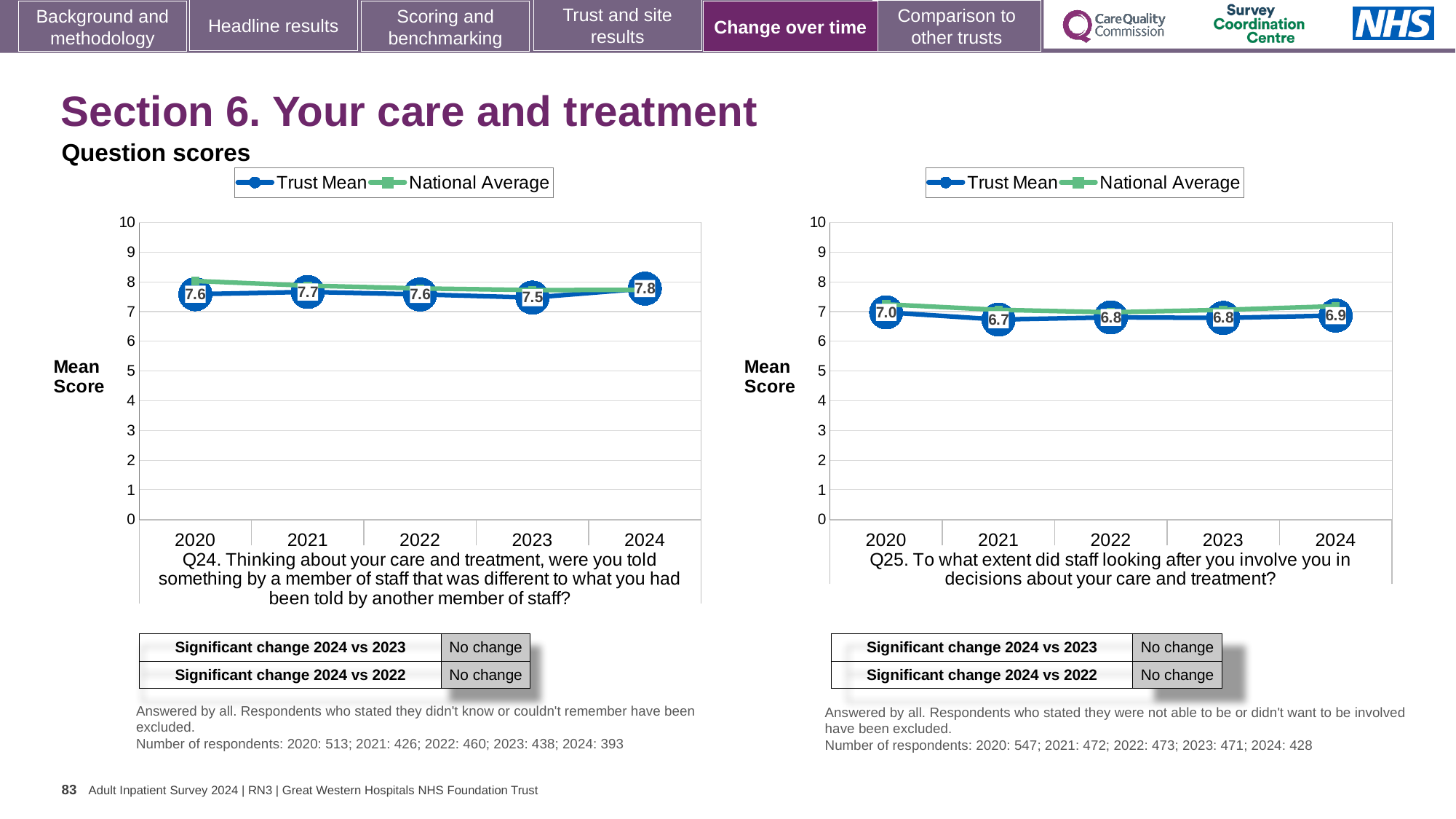
In the Q25 chart on the right, is the National Average value for 2022 greater or less than 8? less In the Q24 chart on the left, is the National Average value for 2020 greater or less than 7? greater In the Q24 chart on the left, what is the difference between the Trust Mean scores for 2024 and 2023? 0.3 In the Q25 chart on the right, which year has the lowest Trust Mean score? 2021 How many years are plotted on the x axis of the Q25 chart on the right? 5 In the Q25 chart on the right, what is the Trust Mean score for 2021? 6.7 What kind of chart is the Q24 chart on the left? Line chart In the Q25 chart on the right, does the Trust Mean score rise or fall from 2020 to 2021? Fall How many series does the legend of the Q24 chart on the left list? 2 In the Q24 chart on the left, which year has the highest Trust Mean score? 2024 In the Q24 chart on the left, what is the Trust Mean score for 2024? 7.8 In the Q25 chart on the right, which is larger, the Trust Mean score for 2020 or for 2021? 2020